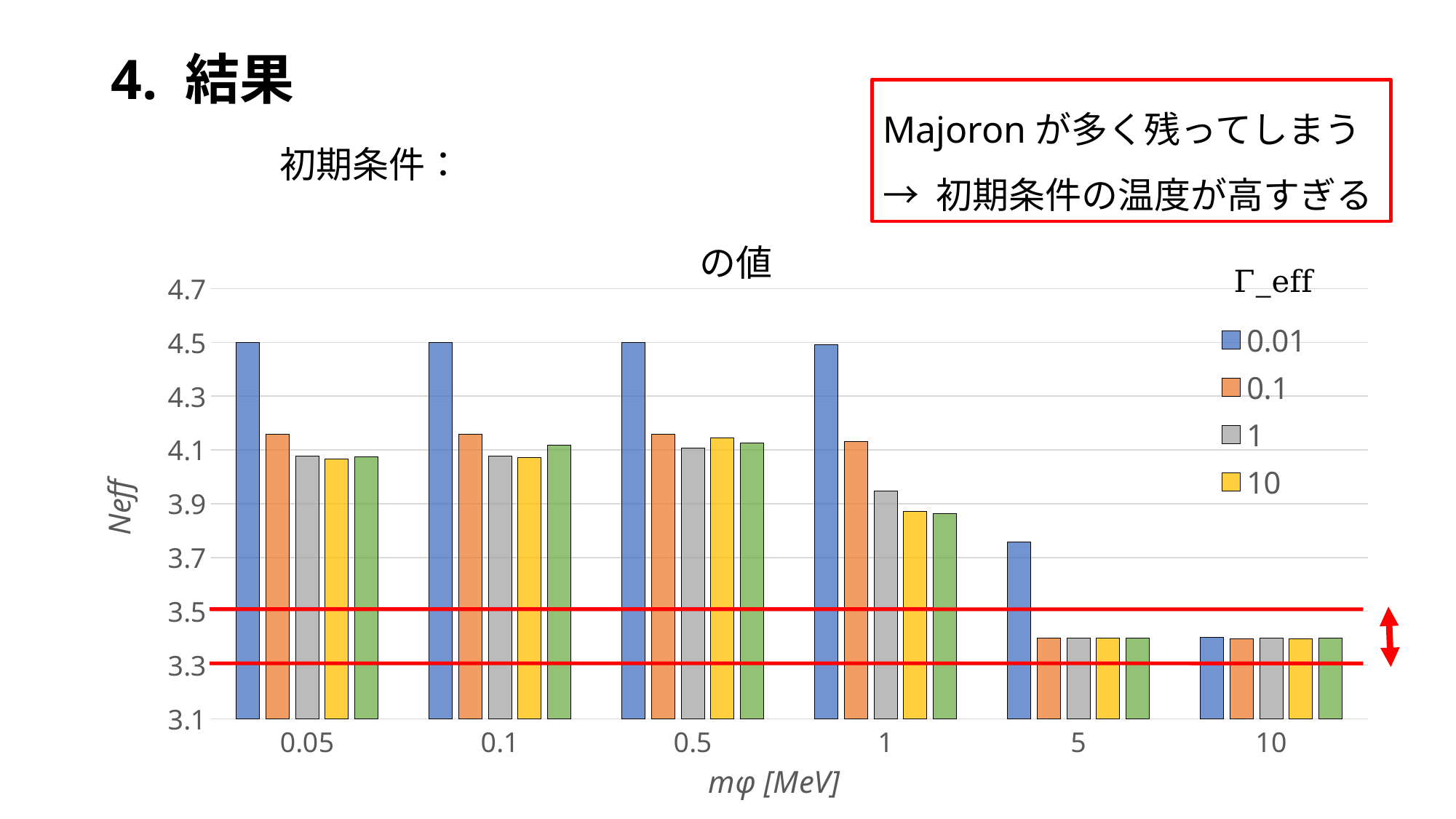
For Γ_eff = 0.01, which is larger: the value at mφ = 1 or at mφ = 5? mφ = 1 What is the label on the x axis of the chart? mφ [MeV] Is the value for Γ_eff = 0.01 at mφ = 5 greater or less than 3.5? greater How many entries does the Γ_eff legend list? 4 Is the value for Γ_eff = 1 at mφ = 1 greater or less than 4.1? less How many mφ categories are shown on the x axis? 6 Is the value for Γ_eff = 0.01 at mφ = 0.05 greater or less than 4.3? greater What kind of chart is shown on the slide? bar chart At mφ = 0.05, which is larger: the value for Γ_eff = 0.01 or for Γ_eff = 0.1? Γ_eff = 0.01 For the Γ_eff = 0.01 series, at which mφ category is the value lowest? 10 Do the values for Γ_eff = 0.01 rise or fall as mφ increases along the x axis? fall